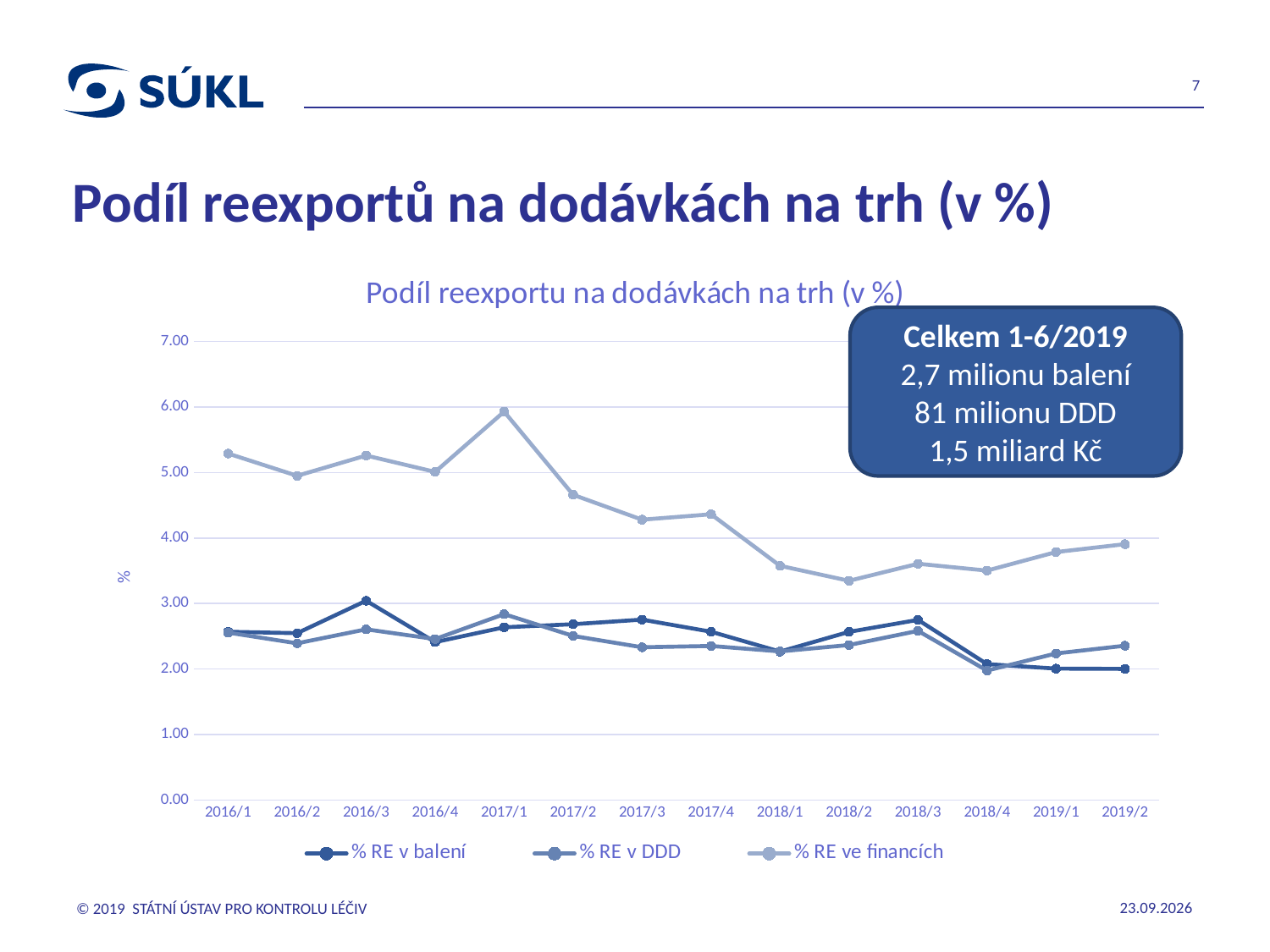
Is the value for '% RE ve financích' in 2017/1 greater or less than 5.00? greater What are the three series listed in the legend? % RE v balení, % RE v DDD, % RE ve financích Is the value for '% RE v balení' in 2019/2 greater or less than 3.00? less Is the value for '% RE ve financích' in 2018/1 greater or less than 4.00? less How many periods are shown on the x axis? 14 What is the title of the chart? Podíl reexportu na dodávkách na trh (v %) In 2017/1, which series has the larger value: '% RE ve financích' or '% RE v balení'? % RE ve financích In which period does the '% RE v balení' series reach its highest value? 2016/3 Does the '% RE ve financích' series overall rise or fall from 2016/1 to 2019/2? fall In which period does the '% RE ve financích' series reach its highest value? 2017/1 What kind of chart is shown on the slide? line chart How many series does the legend list? 3